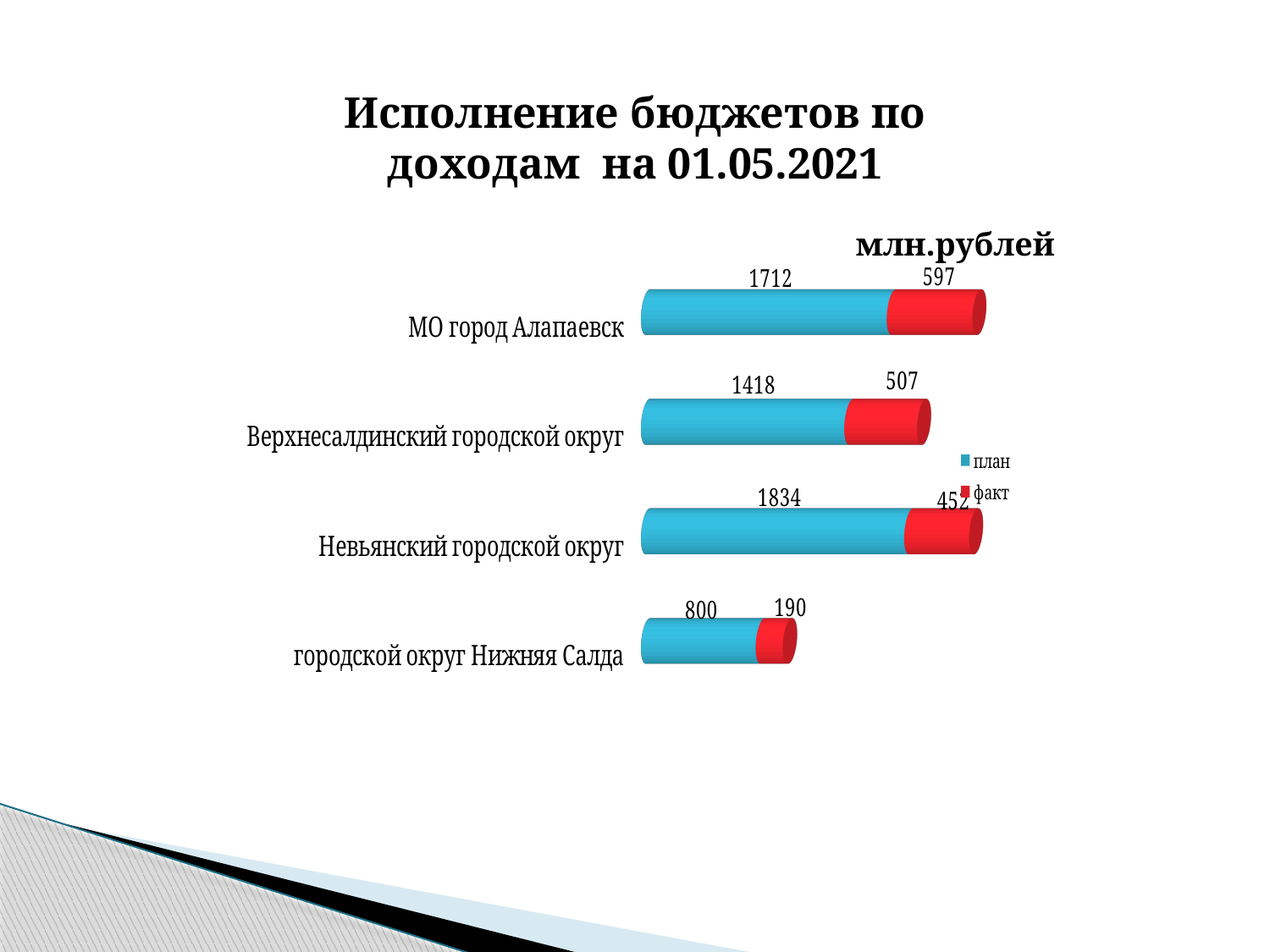
What is the total of the stacked bar for городской округ Нижняя Салда? 990 Which has the larger план value, МО город Алапаевск or Верхнесалдинский городской округ? МО город Алапаевск What is the факт value for Верхнесалдинский городской округ? 507 Which category has the lowest факт value? городской округ Нижняя Салда What is the план value for городской округ Нижняя Салда? 800 How many series does the legend list? 2 What kind of chart is shown on the slide? bar chart What is the difference between the план and факт values for МО город Алапаевск? 1115 Which category has the highest факт value? МО город Алапаевск What is the план value for МО город Алапаевск? 1712 Which category has the highest план value? Невьянский городской округ How many categories are shown in the chart? 4